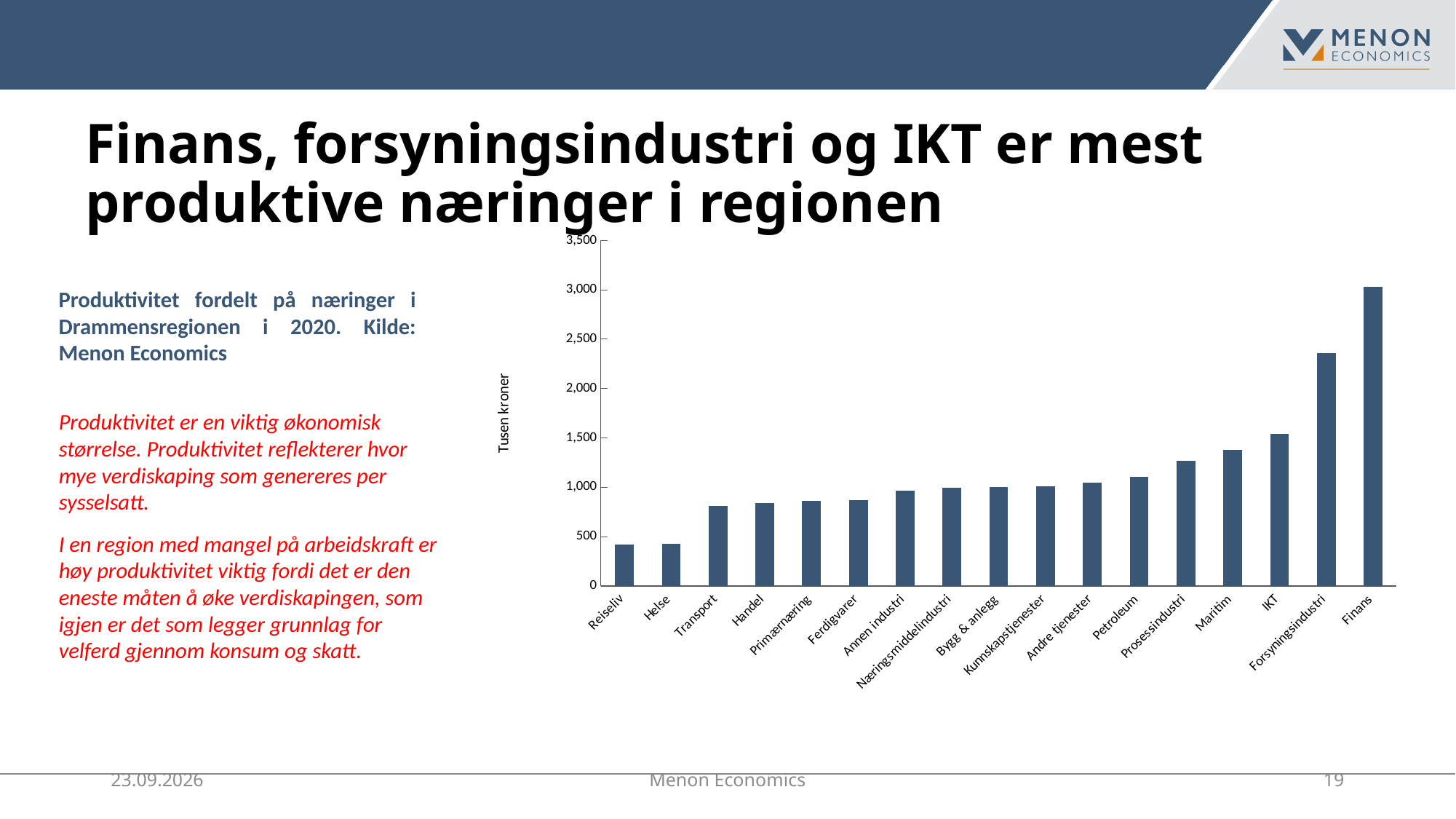
Do the values rise or fall moving from left to right along the x axis? rise How many industries (categories) are shown on the x axis of the chart? 17 Is the value for Transport greater or less than 1,000? less Which has a higher value, Helse or Handel? Handel What kind of chart is shown on the slide? bar chart Which has a higher value, Maritim or Prosessindustri? Maritim Is the value for Forsyningsindustri greater or less than 2,500? less Is the value for Reiseliv greater or less than 500? less Which industry has the highest productivity in the chart? Finans What is the label on the y axis of the chart? Tusen kroner